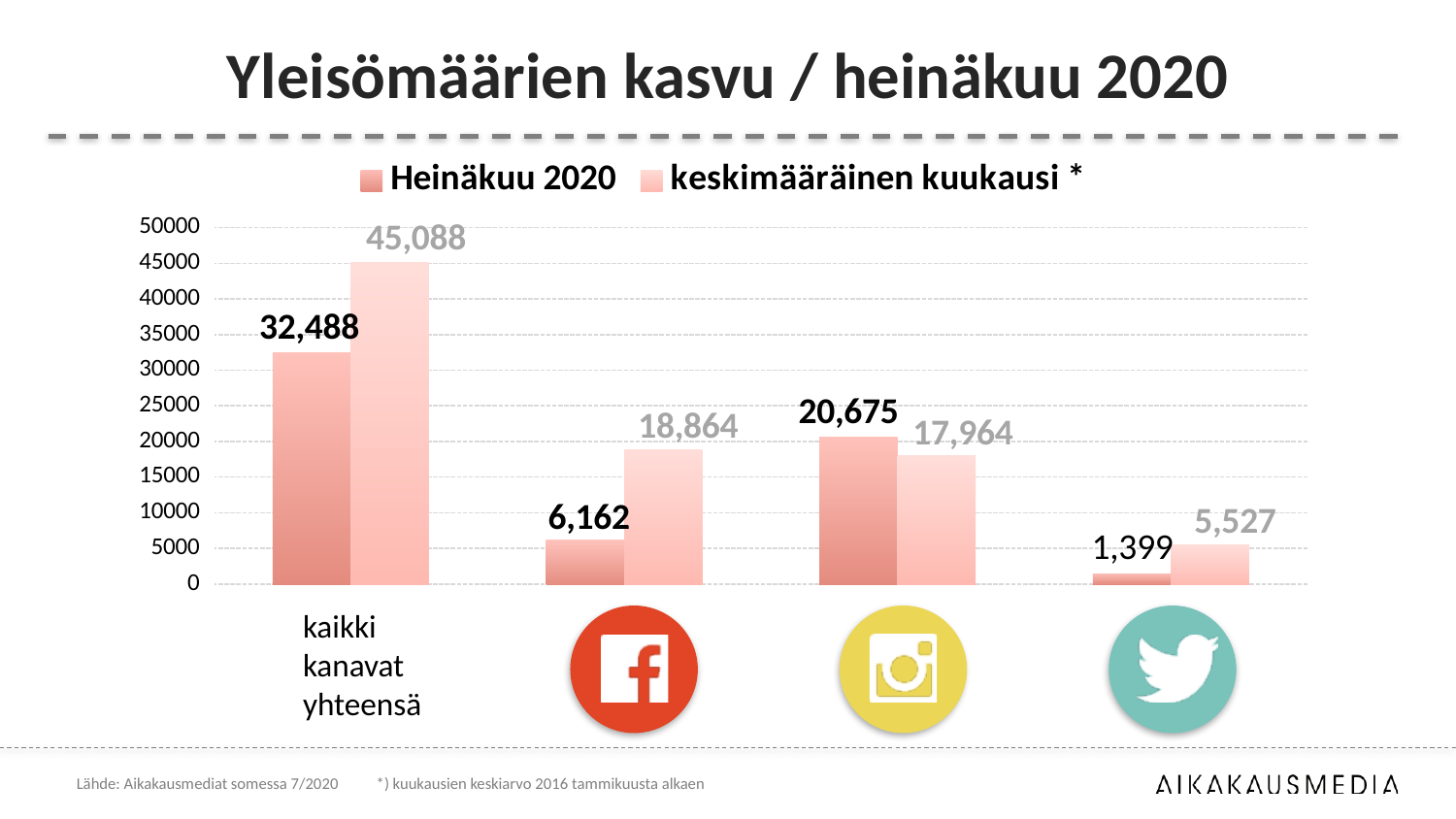
What is the keskimääräinen kuukausi value for kaikki kanavat yhteensä? 45,088 What is the keskimääräinen kuukausi value for the Instagram category? 17,964 What is the Heinäkuu 2020 value for the Twitter category? 1,399 How many series does the legend list? 2 How many categories are shown on the x axis of the chart? 4 What is the Heinäkuu 2020 value for kaikki kanavat yhteensä? 32,488 For the Instagram category, which is larger: the Heinäkuu 2020 value or the keskimääräinen kuukausi value? Heinäkuu 2020 What kind of chart is shown on the slide? Bar chart Which category has the lowest Heinäkuu 2020 value? Twitter What is the Heinäkuu 2020 value for the Facebook category? 6,162 What is the difference between the keskimääräinen kuukausi and Heinäkuu 2020 values for the Facebook category? 12,702 Is the keskimääräinen kuukausi value for the Twitter category greater or less than 5000? greater